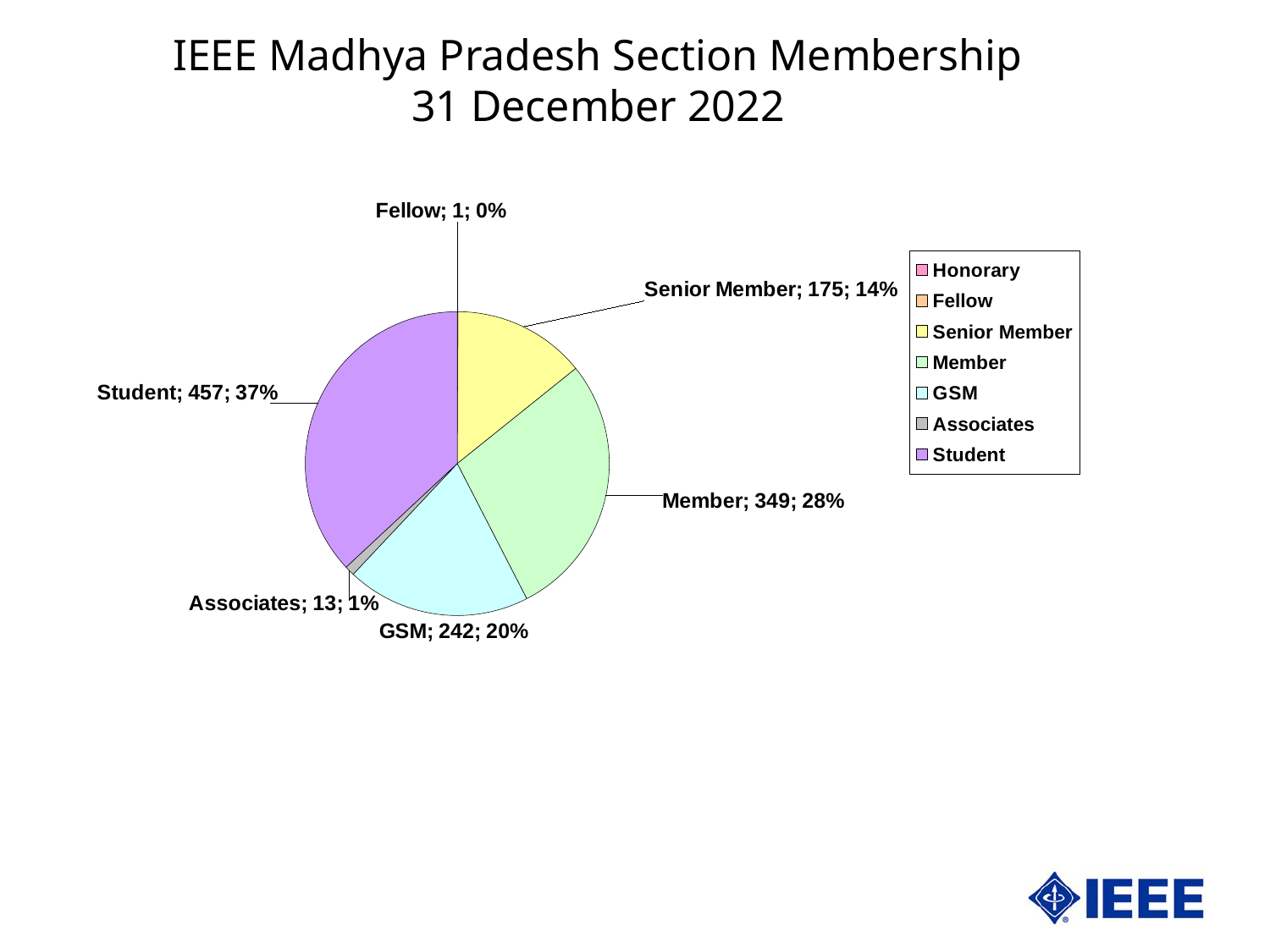
What is the difference between the Student value and the Member value? 108 Which labelled category has the smallest value? Fellow What kind of chart is shown on the slide? pie chart What percentage share is shown for Associates? 1% Which category has the largest slice of the pie? Student How many members are in the GSM category? 242 How many members are in the Student category? 457 Which is larger, the Member value or the GSM value? Member What is the title of the slide containing the chart? IEEE Madhya Pradesh Section Membership 31 December 2022 What is the value shown for Senior Member? 175 How many entries does the legend list? 7 What percentage share of the pie does the Member slice represent? 28%